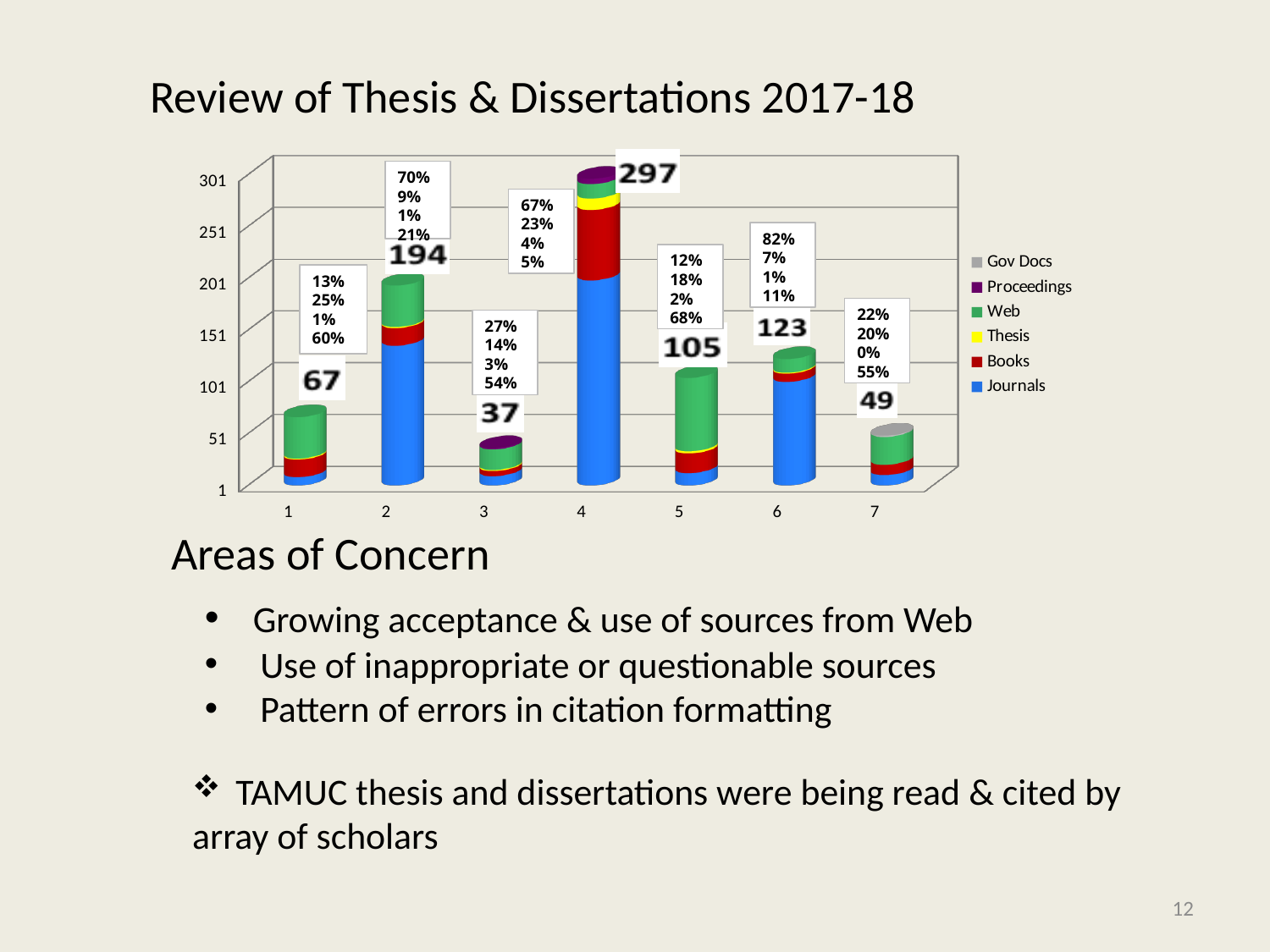
What kind of chart is shown on the slide? stacked bar chart Which category has the lowest total? 3 Is the total for category 5 greater or less than 101? greater What is the total value shown for category 7? 49 What is the total value shown for category 4? 297 What is the total value shown for category 1? 67 Which has a larger total, category 2 or category 6? category 2 What is the difference between the totals for category 2 and category 6? 71 What is the difference between the totals for category 4 and category 3? 260 How many categories are shown on the x axis? 7 How many series does the legend list? 6 Which category has the highest total? 4